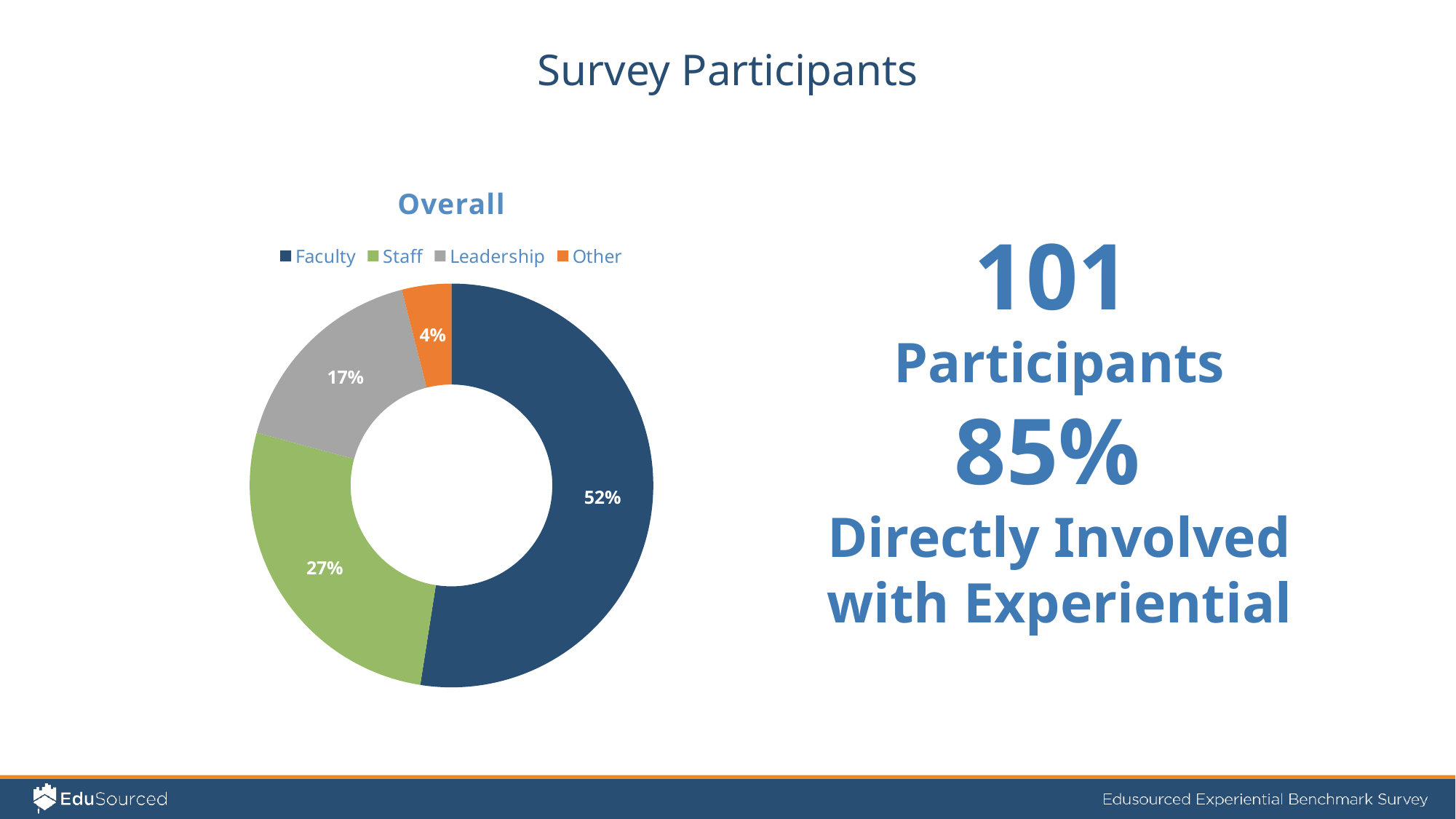
Which is larger, the share for Staff or the share for Leadership? Staff What kind of chart is used to show the survey participants? Pie chart (doughnut) What is the difference in percentage points between Faculty and Staff? 25 Which category has the smallest share of the Overall chart? Other What is the title of the chart? Overall What percentage of survey participants are Staff? 27% What is the difference in percentage points between Leadership and Other? 13 What percentage of survey participants are Leadership? 17% How many categories are shown in the Overall chart? 4 What percentage of survey participants fall under Other? 4% Which category has the largest share of the Overall chart? Faculty What percentage of survey participants are Faculty? 52%